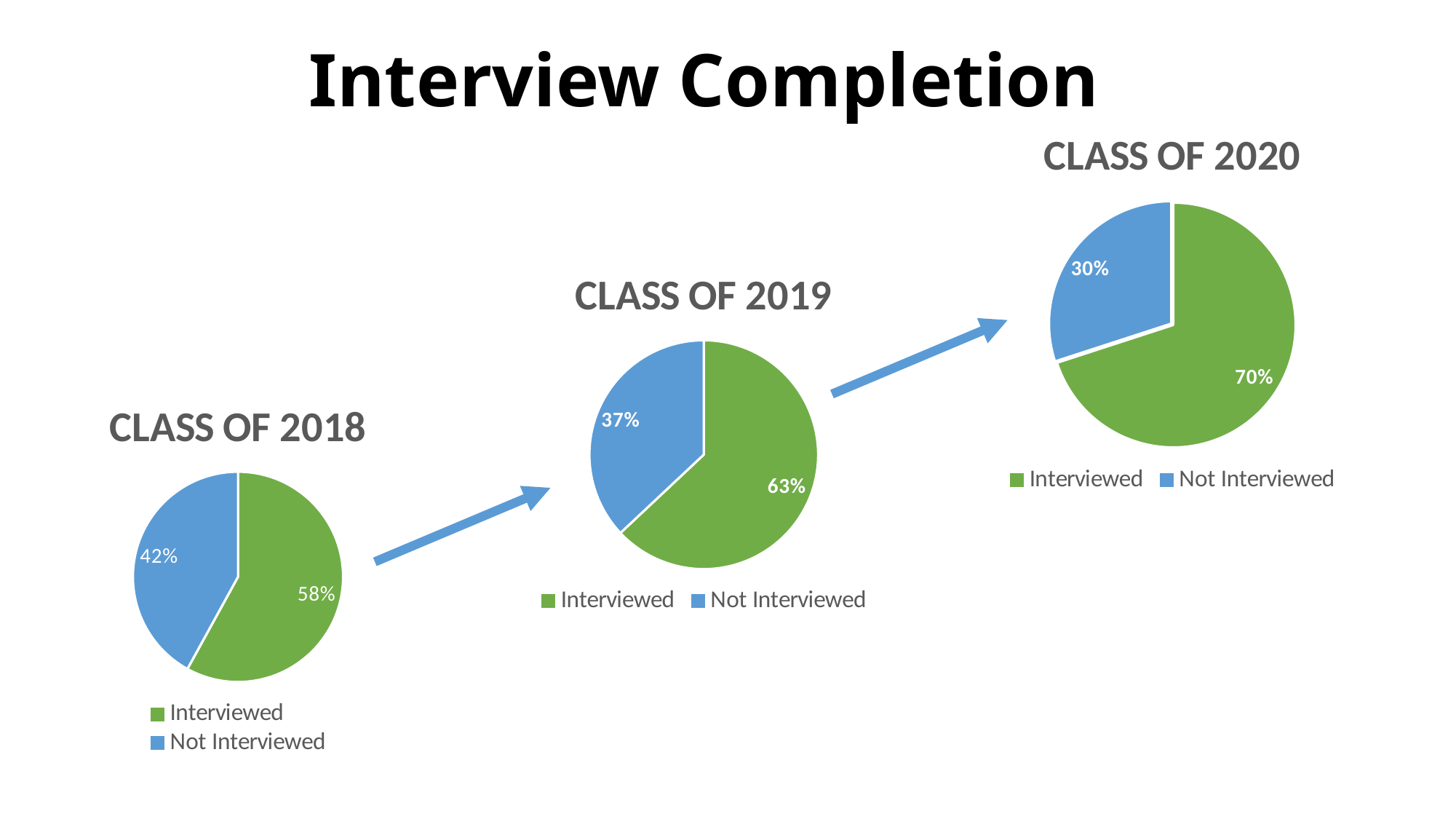
In the Class of 2018 chart, what percentage were Interviewed? 58% In the Class of 2019 chart, what percentage were Not Interviewed? 37% In the Class of 2019 chart, what percentage were Interviewed? 63% How many entries does the legend of the Class of 2020 chart list? 2 In the Class of 2018 chart, which slice is the smallest? Not Interviewed In the Class of 2020 chart, which slice is the largest? Interviewed In the Class of 2020 chart, what percentage were Interviewed? 70% What kind of chart is the Class of 2019 chart? Pie chart In the Class of 2019 chart, what is the difference between the Interviewed and Not Interviewed percentages? 26% Which is larger: the Interviewed share in the Class of 2018 chart or the Interviewed share in the Class of 2020 chart? Class of 2020 In the Class of 2018 chart, what percentage were Not Interviewed? 42% In the Class of 2020 chart, what percentage were Not Interviewed? 30%